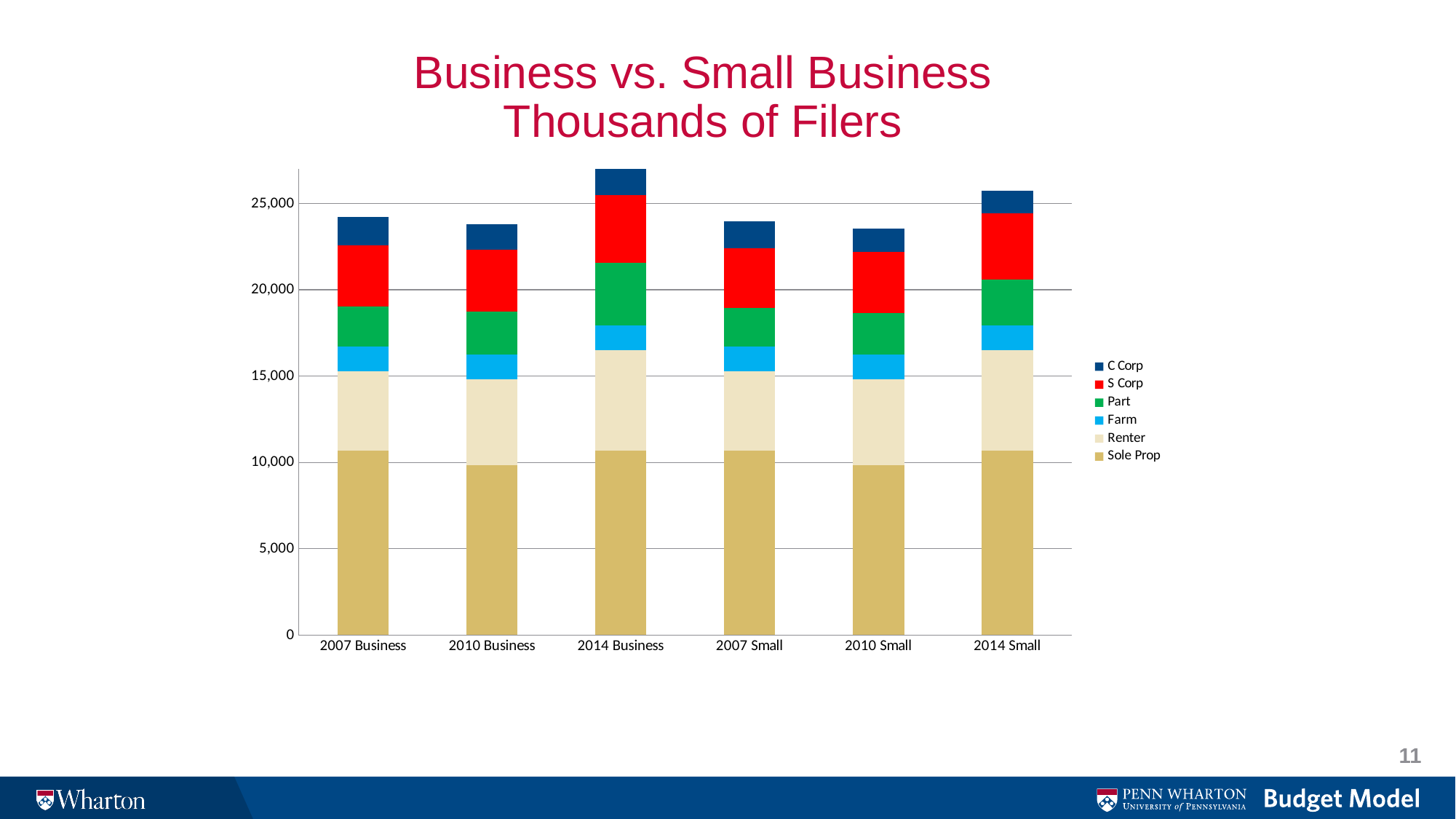
Which has the larger total, 2014 Business or 2007 Business? 2014 Business Is the total for 2010 Small greater or less than 25,000? less What kind of chart is shown on the slide? Stacked bar chart How many series does the legend list? 6 What is the title of the chart? Business vs. Small Business Thousands of Filers Is the total for 2007 Business greater or less than 25,000? less Which category has the tallest stacked bar? 2014 Business Is the total for 2014 Business greater or less than 25,000? greater Which series is shown at the bottom of each stacked bar? Sole Prop How many categories are shown along the x axis? 6 Which has the larger total, 2014 Small or 2010 Small? 2014 Small